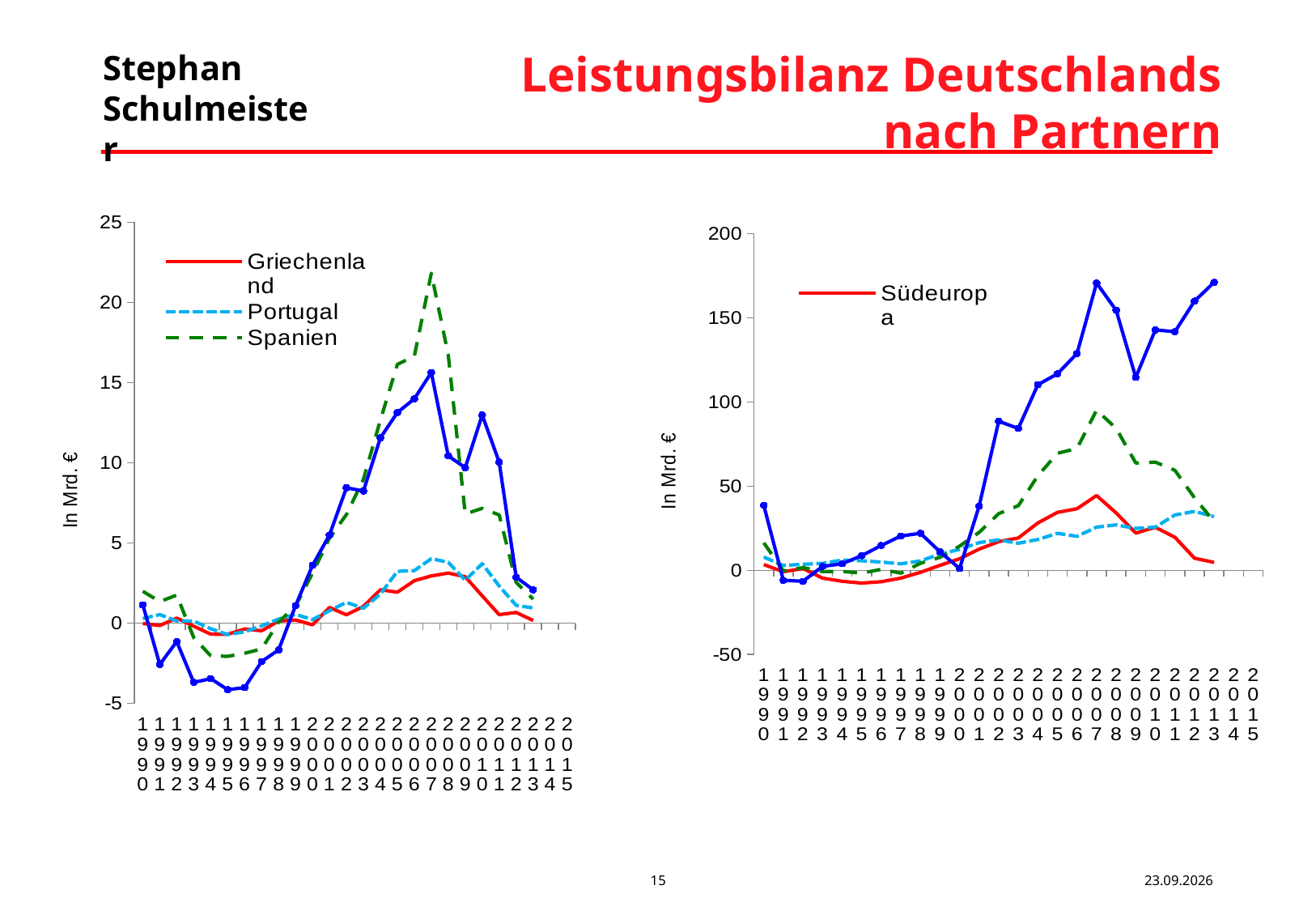
In the left chart, which of the legend series reaches the highest value? Spanien In the right chart, in which year does Südeuropa reach its highest value? 2007 In the right chart, is the value for Südeuropa in 2007 greater or less than 50? less In the left chart, in which year does Spanien reach its highest value? 2007 How many series does the legend of the left chart list? 3 In the left chart, is the value for Griechenland in 2007 greater or less than 5? less How many series does the legend of the right chart list? 1 What type of chart is the left chart on the slide? line chart What is the y-axis label of the left chart? In Mrd. € How many years are shown on the x axis of the right chart? 26 In the left chart, is the value for Spanien in 2007 greater or less than 20? greater